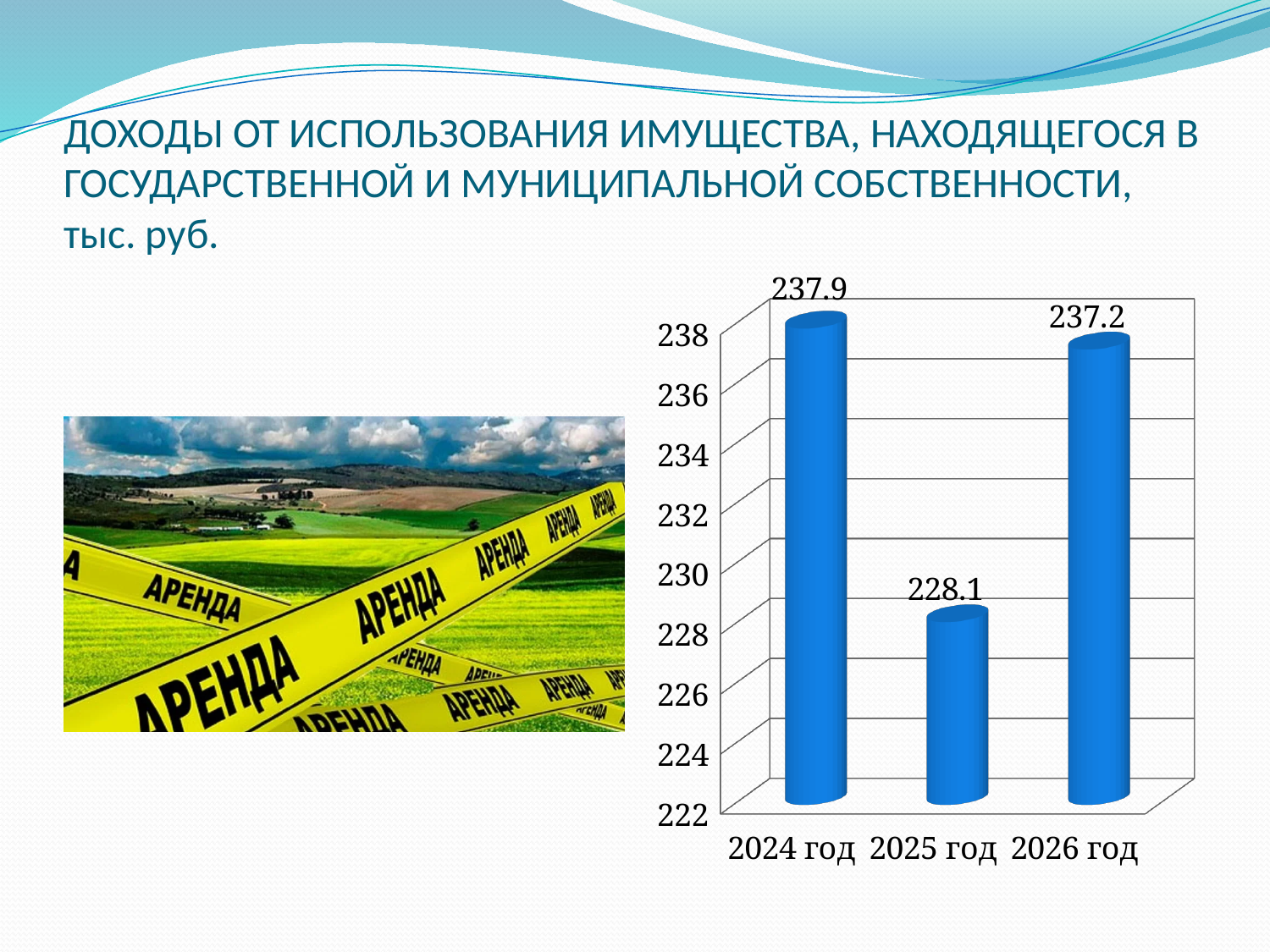
What is the difference between the values for 2026 год and 2025 год? 9.1 What unit of measurement is stated in the slide title? тыс. руб. What is the difference between the values for 2024 год and 2025 год? 9.8 Which is larger, the value for 2024 год or the value for 2026 год? 2024 год Is the value for 2025 год greater or less than 230? less Which year has the lowest value? 2025 год Which year has the highest value? 2024 год What is the value for 2025 год? 228.1 What kind of chart is shown on the slide? bar chart What is the value for 2024 год? 237.9 What is the value for 2026 год? 237.2 How many years are shown on the chart? 3